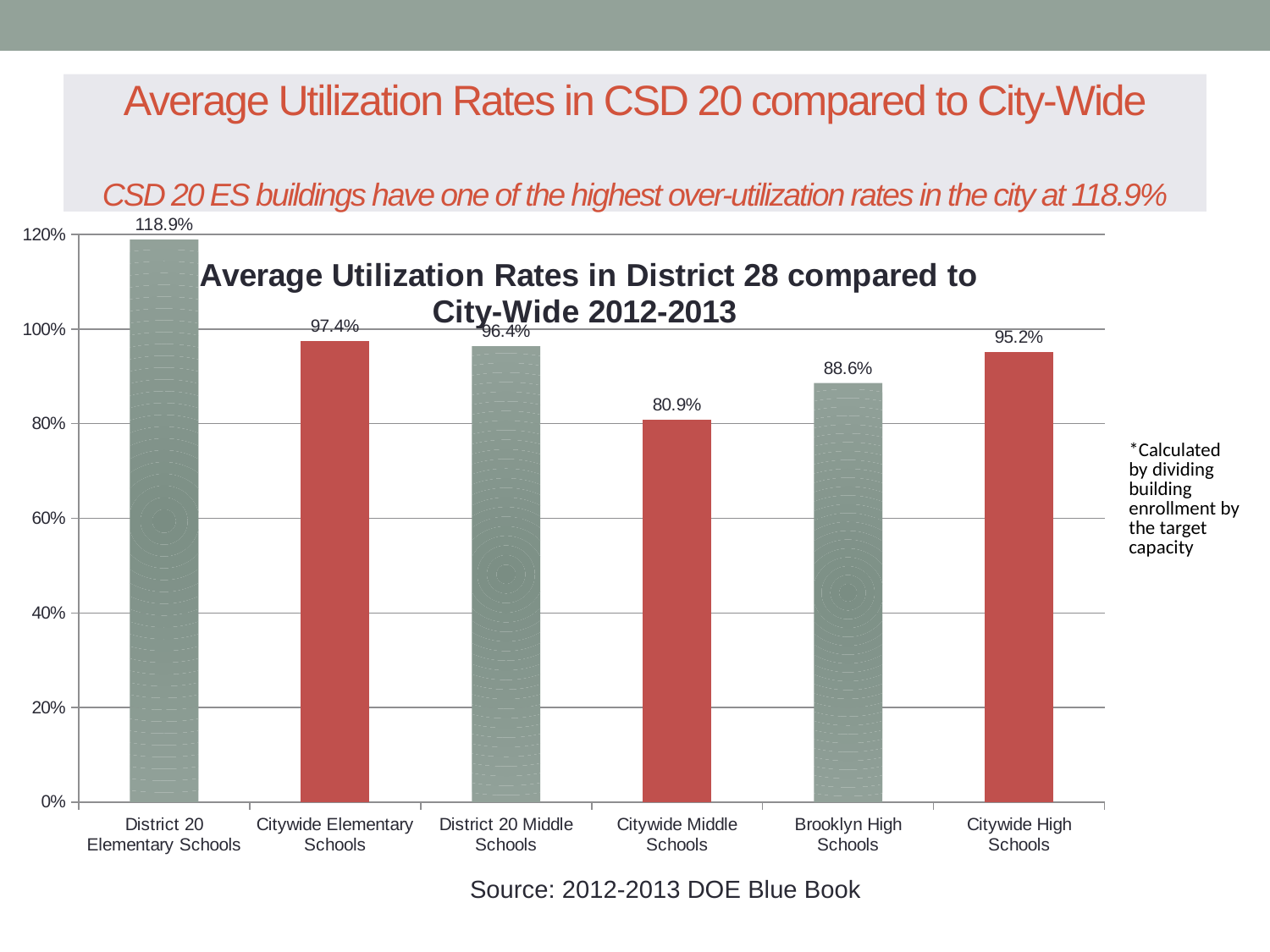
Which category has the lowest utilization rate? Citywide Middle Schools Which category has the highest utilization rate? District 20 Elementary Schools What is the value for Brooklyn High Schools? 88.6% What is the value for District 20 Elementary Schools? 118.9% What is the difference between District 20 Elementary Schools and Citywide Elementary Schools? 21.5% Which is larger, Brooklyn High Schools or Citywide High Schools? Citywide High Schools How many categories are shown on the x axis? 6 What is the difference between District 20 Middle Schools and Citywide Middle Schools? 15.5% What kind of chart is shown on the slide? Bar chart What is the value for Citywide High Schools? 95.2% Is the value for Brooklyn High Schools greater or less than 80%? greater What is the value for Citywide Middle Schools? 80.9%